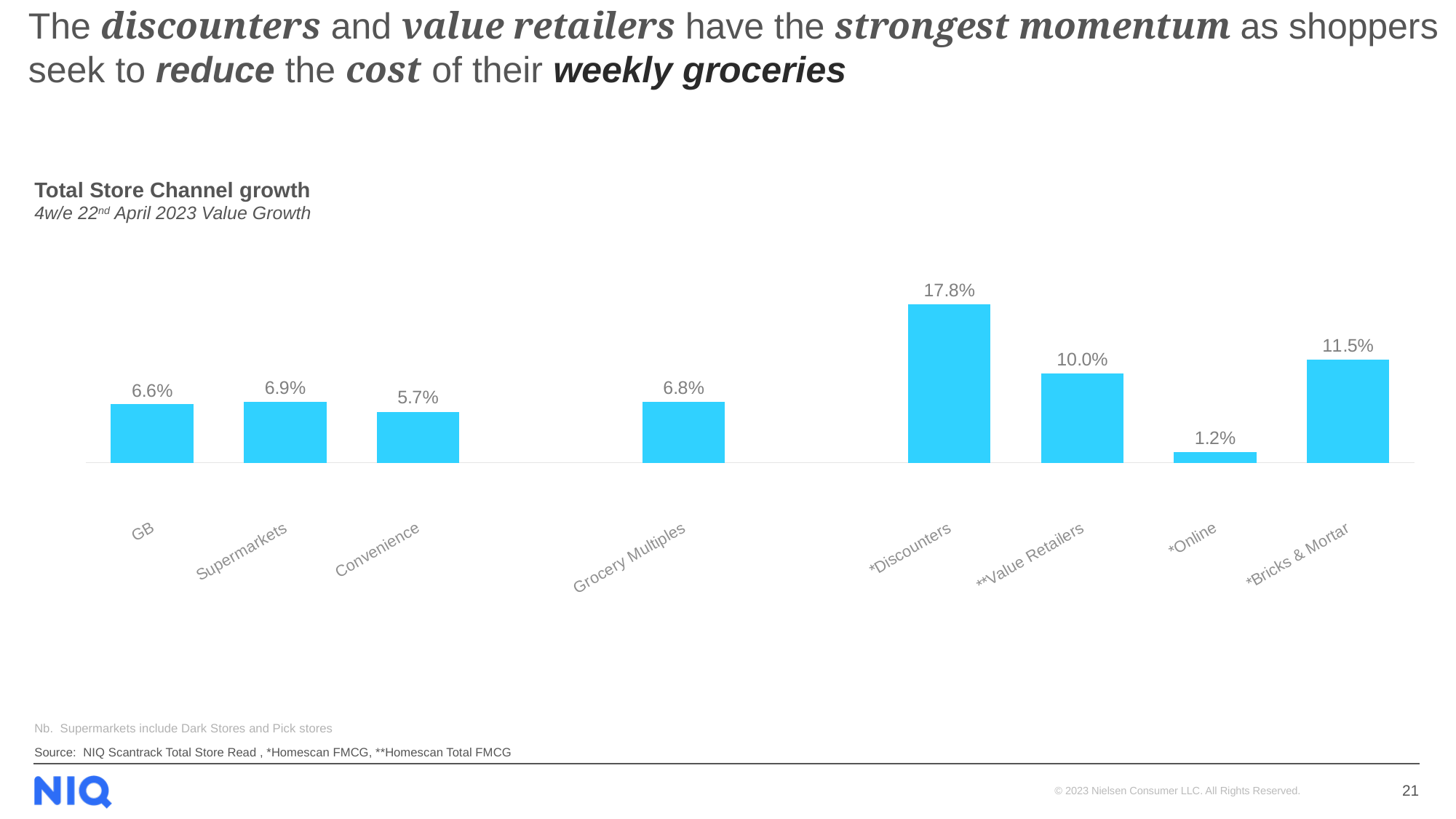
Which channel has the lowest value growth? Online What is the value growth for Bricks & Mortar? 11.5% What is the title of the chart? Total Store Channel growth What is the value growth for Discounters? 17.8% What is the value growth for Online? 1.2% What is the difference between the value growth for Discounters and Value Retailers? 7.8% What is the difference between the value growth for Bricks & Mortar and Online? 10.3% Which has higher value growth, Supermarkets or Convenience? Supermarkets How many channels are shown in the chart? 8 What is the value growth for Supermarkets? 6.9% Which channel has the highest value growth? Discounters What type of chart is shown on the slide? Bar chart